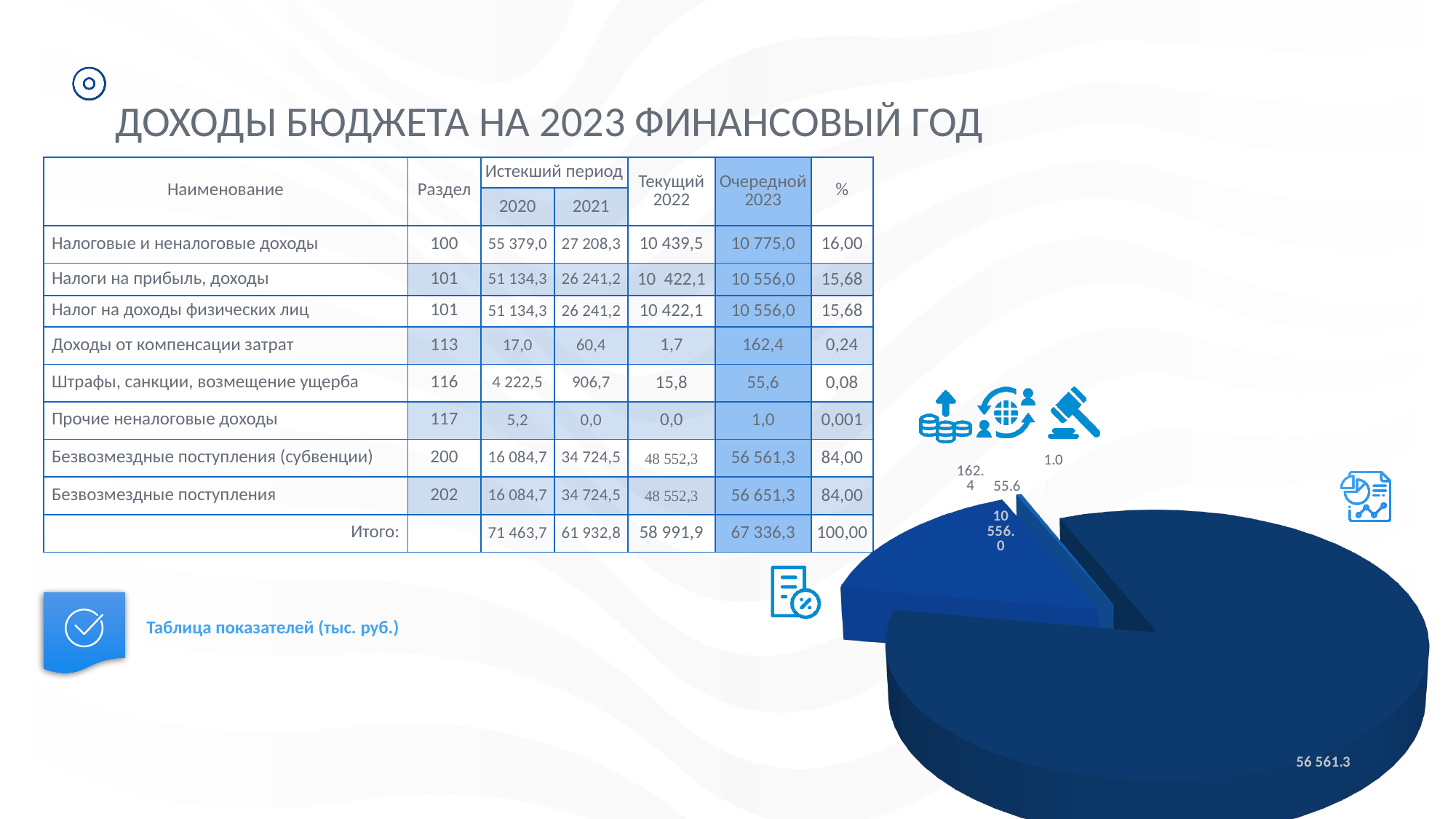
Does the pie chart display a legend? No Is the pie chart drawn in 3D or flat 2D style? 3D In the pie chart, which is larger: the slice labelled 56 561.3 or the slice labelled 10 556.0? 56 561.3 In the pie chart, what is the difference between the slice labelled 56 561.3 and the slice labelled 10 556.0? 46 005.3 What is the sum of all the values labelled on the pie chart? 67 336.3 How many data labels (slices) are shown on the pie chart? 5 In the pie chart, what is the smallest labelled value? 1.0 In the pie chart, what is the value of the second-largest slice? 10 556.0 In the pie chart, what is the difference between the slice labelled 162.4 and the slice labelled 55.6? 106.8 What kind of chart is shown on the right side of the slide? pie chart In the pie chart, what is the value of the largest slice? 56 561.3